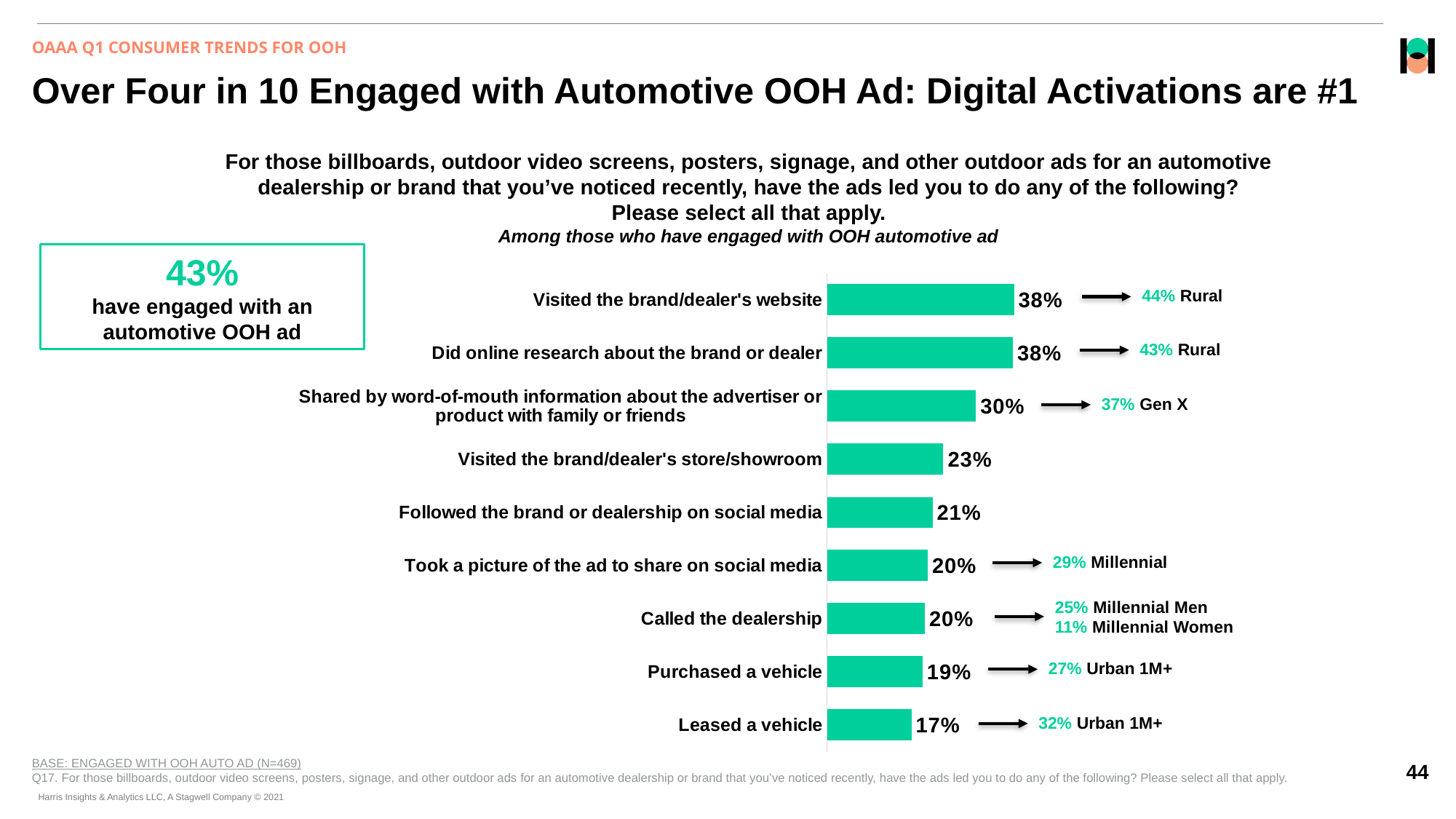
How many categories are shown in the bar chart? 9 What is the value for "Shared by word-of-mouth information about the advertiser or product with family or friends"? 30% What is the Rural value annotated next to "Visited the brand/dealer's website"? 44% What is the difference between "Visited the brand/dealer's website" and "Leased a vehicle"? 21 percentage points What is the difference between "Did online research about the brand or dealer" and "Purchased a vehicle"? 19 percentage points Which is larger: the value for "Visited the brand/dealer's store/showroom" or for "Called the dealership"? Visited the brand/dealer's store/showroom Which category has the lowest value in the chart? Leased a vehicle What percentage of respondents visited the brand/dealer's store/showroom? 23% What type of chart is shown on the slide? Bar chart What percentage of respondents have engaged with an automotive OOH ad, according to the callout box? 43% What is the value for "Leased a vehicle"? 17% What percentage followed the brand or dealership on social media? 21%